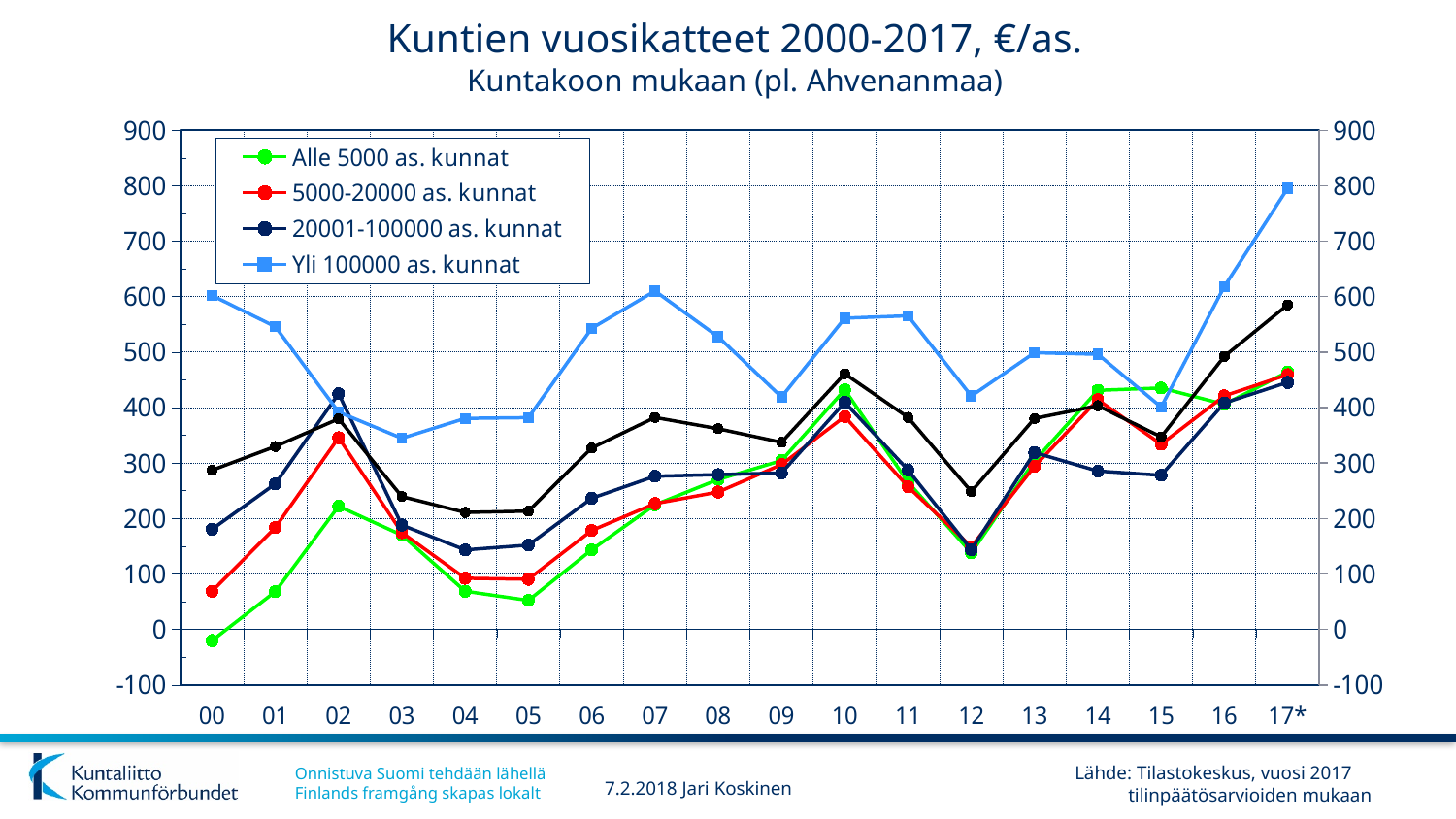
In 02, which is larger: '20001-100000 as. kunnat' or '5000-20000 as. kunnat'? 20001-100000 as. kunnat What kind of chart is shown on the slide? line chart Is the value for 'Yli 100000 as. kunnat' in 17* greater or less than 700? greater What is the main title of the chart? Kuntien vuosikatteet 2000-2017, €/as. Is the value for '5000-20000 as. kunnat' in 02 greater or less than 300? greater In which year does the 'Yli 100000 as. kunnat' series reach its highest value? 17* Is the value for 'Alle 5000 as. kunnat' in 00 greater or less than 0? less How many years are shown along the x axis? 18 In which year does the 'Yli 100000 as. kunnat' series have its lowest value? 03 In which year does the 'Alle 5000 as. kunnat' series have its lowest value? 00 Does the 'Yli 100000 as. kunnat' series rise or fall from 15 to 17*? rise How many series does the legend list? 4